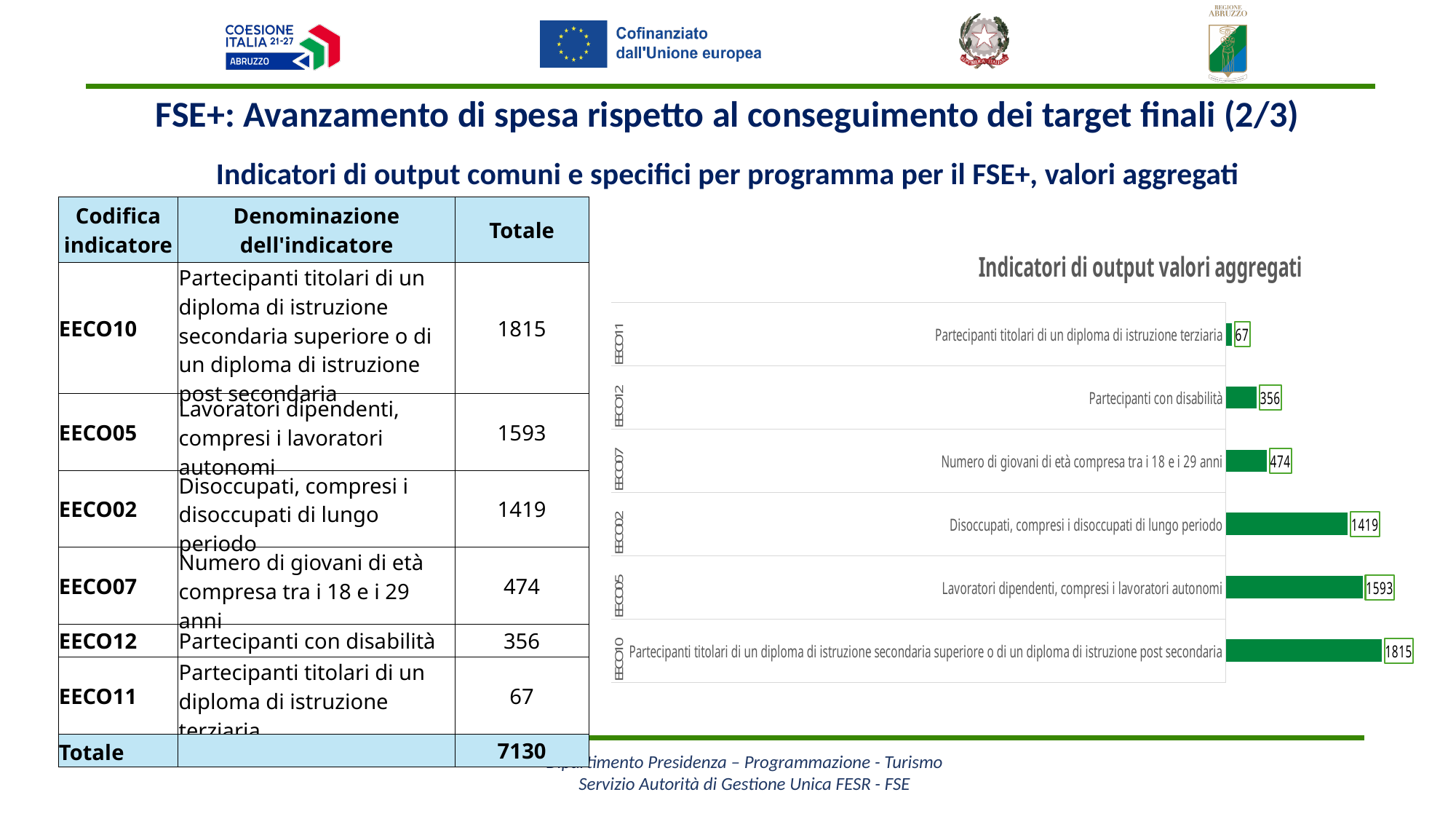
What is the value for 'Partecipanti con disabilità' (EECO12) in the chart? 356 What kind of chart is shown on the slide? Bar chart Which indicator has the lowest value in the chart? EECO11 (Partecipanti titolari di un diploma di istruzione terziaria) What is the value for 'Numero di giovani di età compresa tra i 18 e i 29 anni' (EECO07) in the chart? 474 What is the value for 'Lavoratori dipendenti, compresi i lavoratori autonomi' (EECO05) in the chart? 1593 Which is larger in the chart: the value for 'Disoccupati, compresi i disoccupati di lungo periodo' or the value for 'Lavoratori dipendenti, compresi i lavoratori autonomi'? Lavoratori dipendenti, compresi i lavoratori autonomi What is the value for 'Partecipanti titolari di un diploma di istruzione terziaria' (EECO11) in the chart? 67 What is the difference between the values for EECO07 and EECO12 in the chart? 118 What is the title of the chart? Indicatori di output valori aggregati Which indicator has the highest value in the chart? EECO10 (Partecipanti titolari di un diploma di istruzione secondaria superiore o di un diploma di istruzione post secondaria) What is the difference between the values for EECO10 and EECO05 in the chart? 222 How many indicators (bars) are shown in the chart? 6